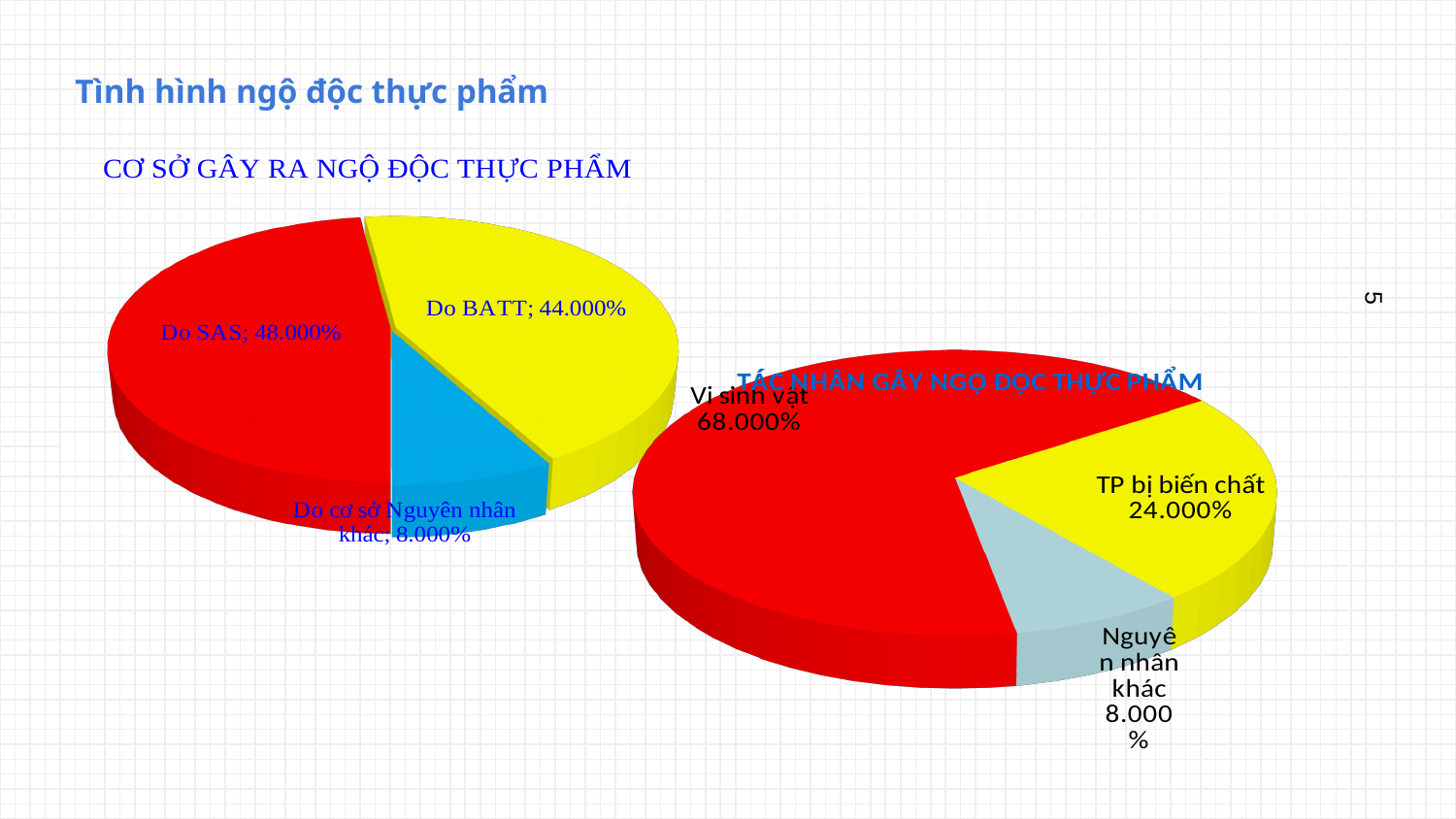
In the left pie chart (CƠ SỞ GÂY RA NGỘ ĐỘC THỰC PHẨM), what is the value for Do BATT? 44.000% In the left pie chart (CƠ SỞ GÂY RA NGỘ ĐỘC THỰC PHẨM), what is the value for Do SAS? 48.000% In the left pie chart (CƠ SỞ GÂY RA NGỘ ĐỘC THỰC PHẨM), how many slices are there? 3 In the right pie chart (TÁC NHÂN GÂY NGỘ ĐỘC THỰC PHẨM), what is the value for Vi sinh vật? 68.000% In the right pie chart (TÁC NHÂN GÂY NGỘ ĐỘC THỰC PHẨM), what is the value for TP bị biến chất? 24.000% In the left pie chart (CƠ SỞ GÂY RA NGỘ ĐỘC THỰC PHẨM), what is the difference between Do SAS and Do BATT? 4.000% In the left pie chart (CƠ SỞ GÂY RA NGỘ ĐỘC THỰC PHẨM), which category has the smallest share? Do cơ sở Nguyên nhân khác What type of chart is the left chart (CƠ SỞ GÂY RA NGỘ ĐỘC THỰC PHẨM)? Pie chart In the right pie chart (TÁC NHÂN GÂY NGỘ ĐỘC THỰC PHẨM), what colour is the Vi sinh vật slice? Red In the right pie chart (TÁC NHÂN GÂY NGỘ ĐỘC THỰC PHẨM), which is larger: TP bị biến chất or Nguyên nhân khác? TP bị biến chất In the right pie chart (TÁC NHÂN GÂY NGỘ ĐỘC THỰC PHẨM), what is the difference between Vi sinh vật and TP bị biến chất? 44.000% In the right pie chart (TÁC NHÂN GÂY NGỘ ĐỘC THỰC PHẨM), which category has the largest share? Vi sinh vật